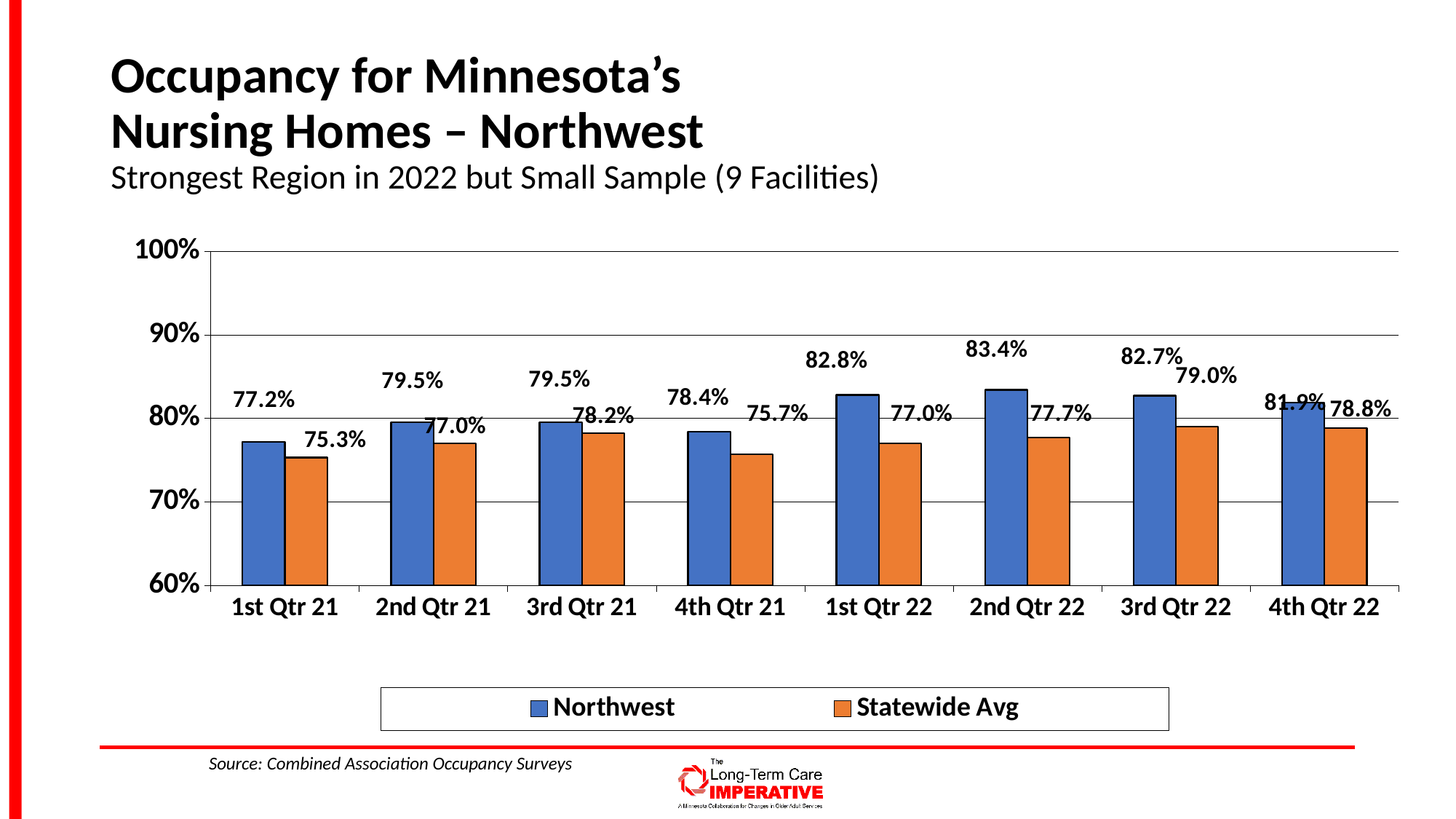
How many quarters are shown on the x axis? 8 What is the Northwest occupancy value for 4th Qtr 21? 78.4% What is the difference between the Northwest and Statewide Avg values in 1st Qtr 22? 5.8% What kind of chart is shown on the slide? bar chart What is the Northwest occupancy value for 2nd Qtr 22? 83.4% How many series does the legend list? 2 Which colour represents the Statewide Avg series? orange What is the Statewide Avg occupancy value for 1st Qtr 21? 75.3% Is the Northwest value for 1st Qtr 21 greater or less than 80%? less In which quarter is the Statewide Avg occupancy lowest? 1st Qtr 21 Which is larger in 3rd Qtr 22, the Northwest value or the Statewide Avg value? Northwest In which quarter is the Northwest occupancy highest? 2nd Qtr 22